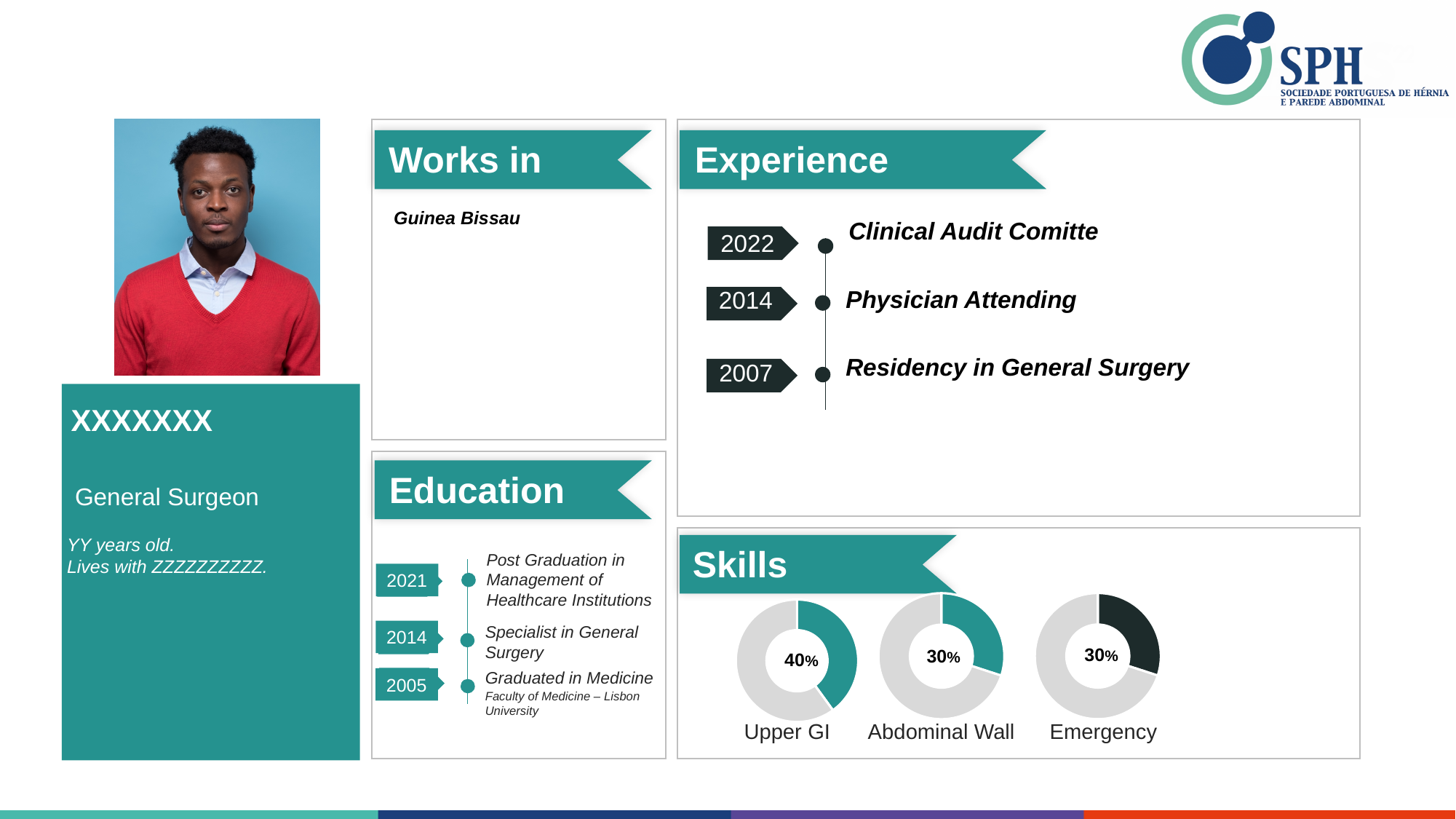
What share of the Upper GI donut chart is filled in? 40% How many donut charts are shown in the Skills section? 3 In the Skills section, which two skills show the same percentage? Abdominal Wall and Emergency Among the Skills charts, which skill has the highest percentage? Upper GI In the Skills section, what value is shown on the Upper GI donut chart? 40% What are the labels of the three donut charts in the Skills section, from left to right? Upper GI, Abdominal Wall, Emergency In the Skills section, what value is shown on the Emergency donut chart? 30% In the Skills section, what value is shown on the Abdominal Wall donut chart? 30% In the Skills section, which is larger: the Upper GI value or the Abdominal Wall value? Upper GI In the Skills section, what is the difference between the Upper GI value and the Emergency value? 10% What kind of charts are used in the Skills section? Donut charts In the Skills section, which donut chart uses a dark (near-black) fill instead of teal? Emergency